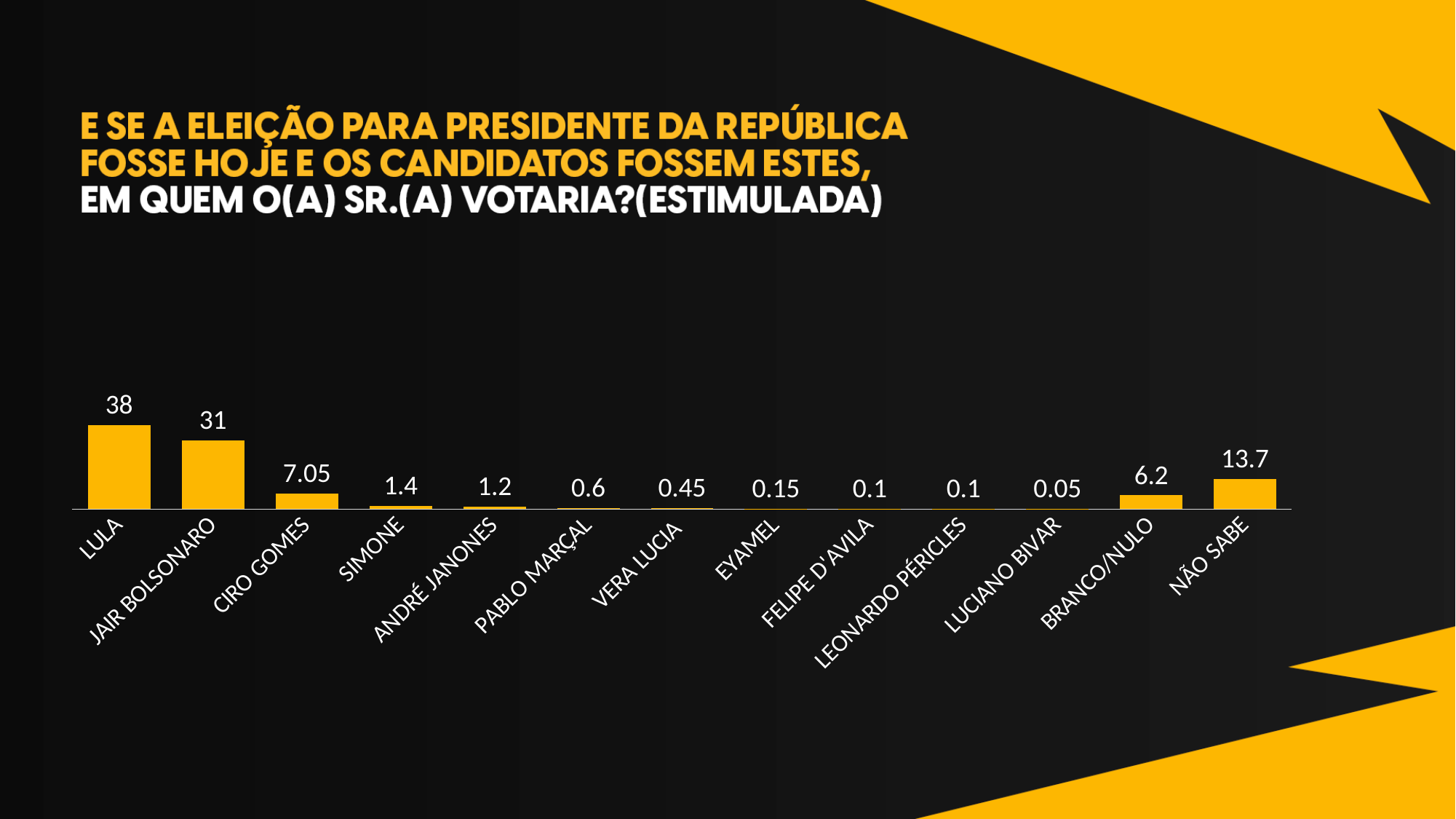
What is the value for BRANCO/NULO? 6.2 What is the difference between the values for LULA and JAIR BOLSONARO? 7 Which category has the highest value? LULA Which category has the lowest value? LUCIANO BIVAR What kind of chart is shown on the slide? Bar chart What is the value for CIRO GOMES? 7.05 What is the value for NÃO SABE? 13.7 What is the value for VERA LUCIA? 0.45 How many categories are shown in the chart? 13 Which is larger, the value for NÃO SABE or the value for CIRO GOMES? NÃO SABE What is the value for LULA? 38 What is the value for JAIR BOLSONARO? 31